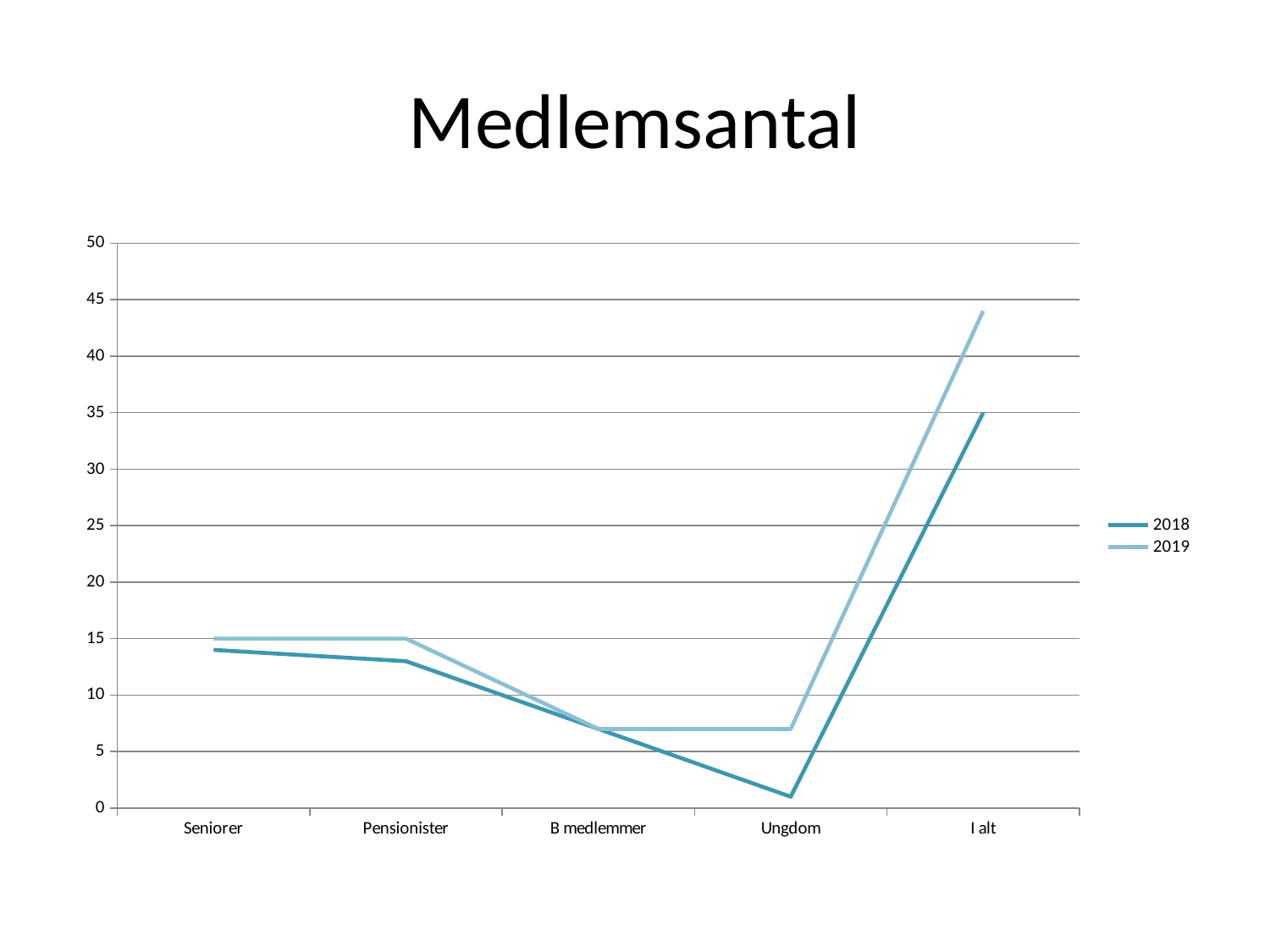
What is the value for Seniorer in the 2019 series? 15 What is the title of the chart? Medlemsantal Does the 2018 line rise or fall from Seniorer to Ungdom? fall Is the value for I alt in the 2019 series greater or less than 40? greater Which category has the lowest value in the 2018 series? Ungdom For Ungdom, which series has the larger value, 2018 or 2019? 2019 What kind of chart is shown on the slide? line chart Which category has the highest value in the 2019 series? I alt What is the value for I alt in the 2018 series? 35 How many categories are shown on the x axis? 5 How many series does the legend list? 2 Is the value for Ungdom in the 2018 series greater or less than 5? less